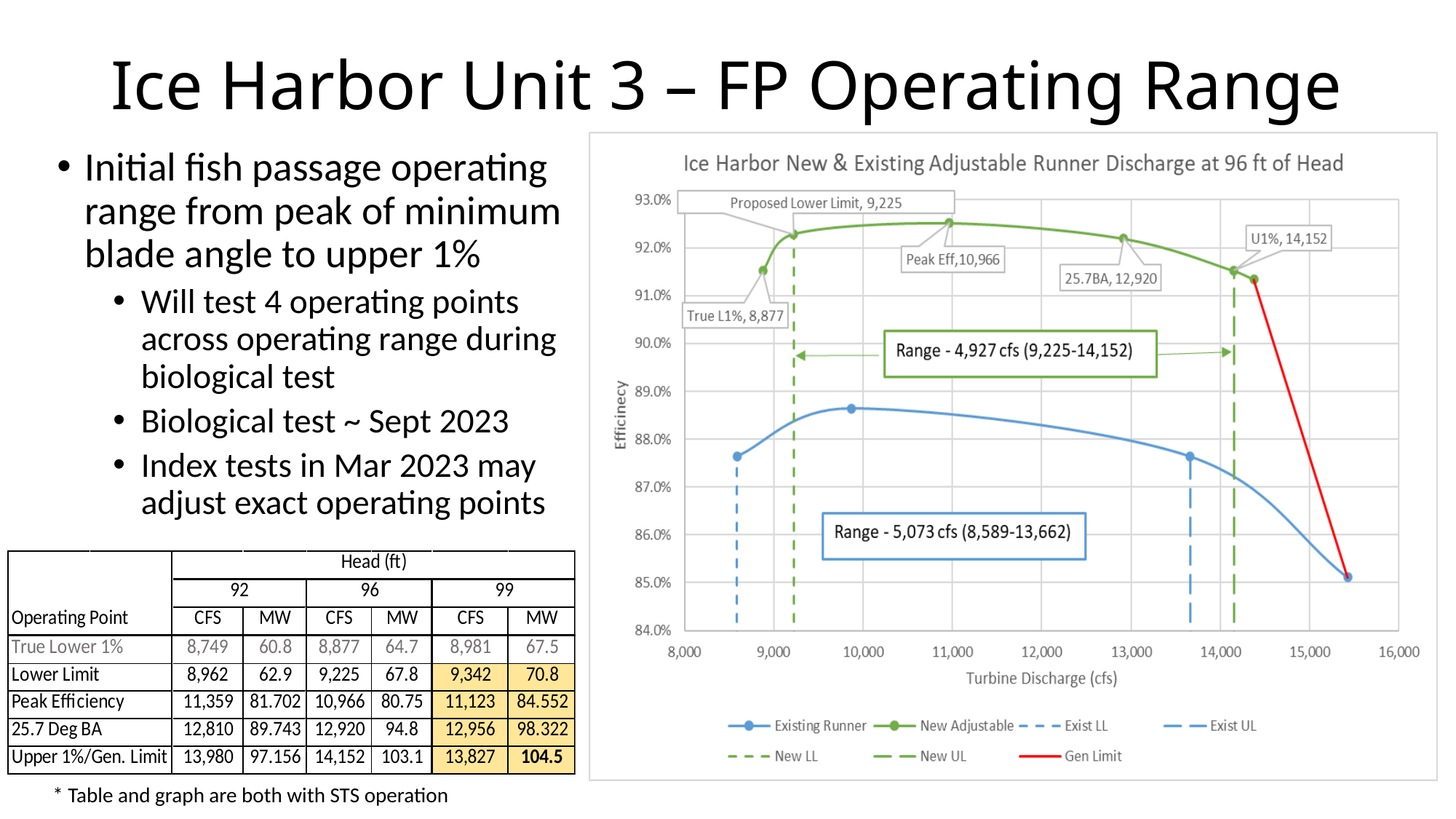
What kind of chart is shown on the slide? line chart What is the title of the chart? Ice Harbor New & Existing Adjustable Runner Discharge at 96 ft of Head What operating range in cfs is given in the green box for the New Adjustable runner? 4,927 cfs Which curve shows higher efficiency at a turbine discharge of 11,000 cfs, Existing Runner or New Adjustable? New Adjustable What turbine discharge is labelled as True L1% on the chart? 8,877 How many entries does the chart legend list? 7 What turbine discharge is labelled as U1% on the chart? 14,152 What turbine discharge is labelled as the Proposed Lower Limit? 9,225 Is the highest efficiency of the Existing Runner curve greater or less than 89.0%? less What operating range in cfs is given in the blue box for the Existing Runner? 5,073 cfs What turbine discharge is labelled as Peak Eff on the New Adjustable curve? 10,966 Is the efficiency of the New Adjustable curve at its Peak Eff point greater or less than 92.0%? greater